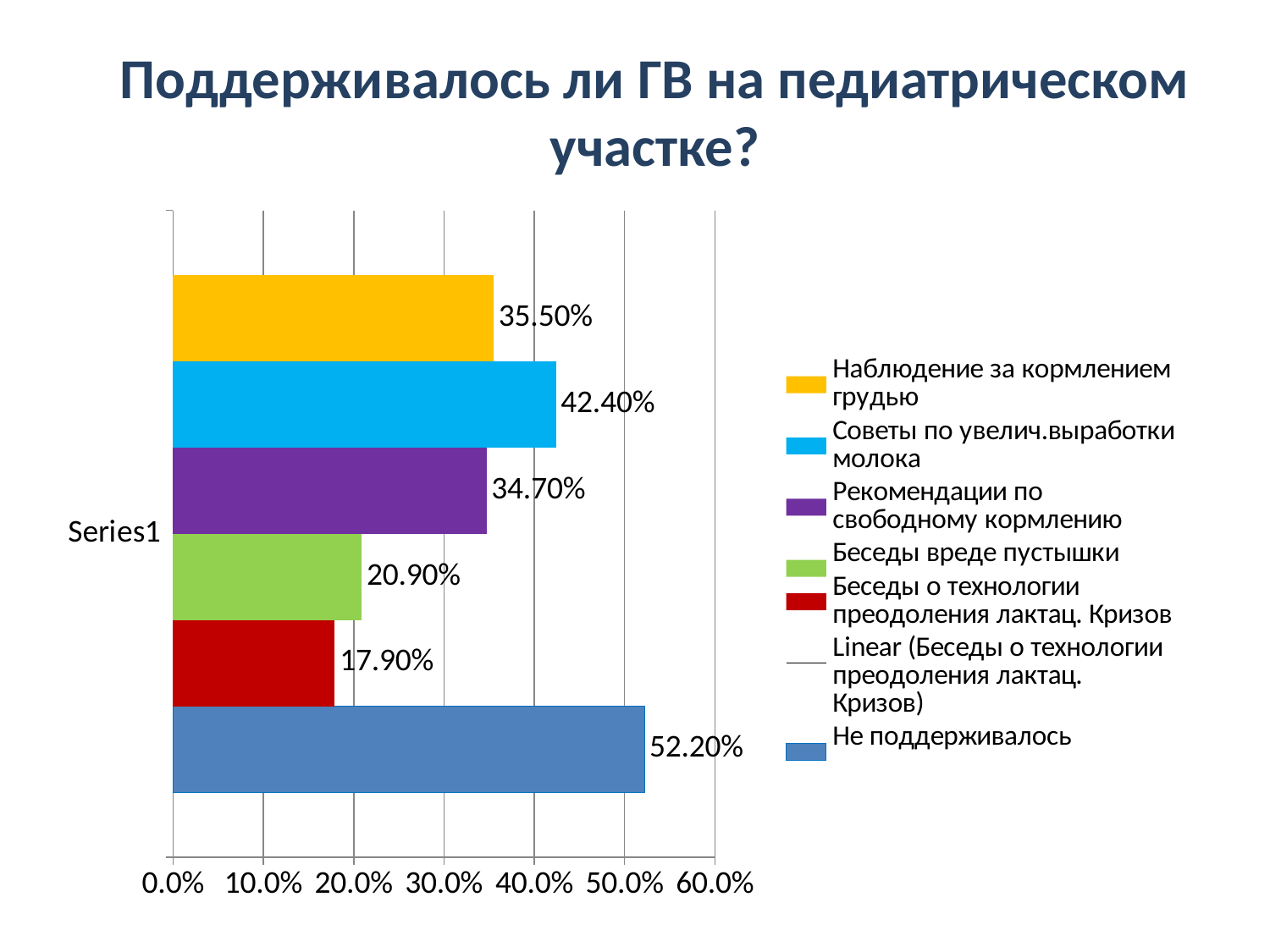
Which series has the highest value? Не поддерживалось What is the difference between the values for "Не поддерживалось" and "Советы по увелич.выработки молока"? 9.80% How many entries does the legend list? 7 What is the value for "Советы по увелич.выработки молока"? 42.40% What is the value for "Беседы вреде пустышки"? 20.90% What type of chart is shown on the slide? bar chart Which is larger: the value for "Наблюдение за кормлением грудью" or for "Рекомендации по свободному кормлению"? Наблюдение за кормлением грудью What is the value for "Беседы о технологии преодоления лактац. Кризов"? 17.90% Which series has the lowest value? Беседы о технологии преодоления лактац. Кризов Is the value for "Не поддерживалось" greater or less than 50.0%? greater What is the value for "Не поддерживалось"? 52.20% What is the title of the chart? Поддерживалось ли ГВ на педиатрическом участке?